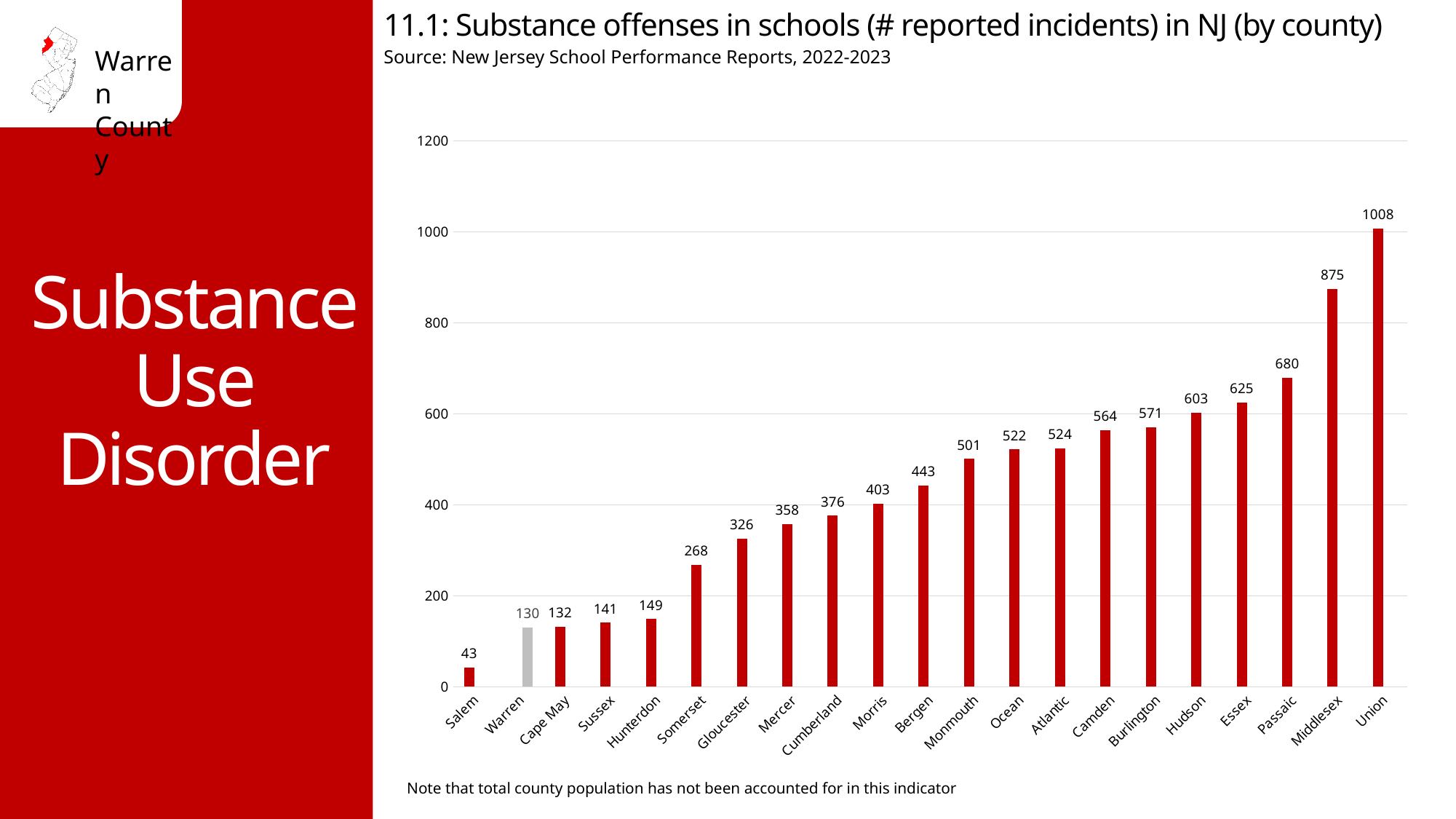
What is the value shown for Union county? 1008 Which county's bar is coloured grey instead of red? Warren Which county has the lowest number of reported incidents? Salem How many counties are shown on the x axis? 21 Which county has the highest number of reported incidents? Union What is the difference between the values for Middlesex and Passaic? 195 Is the value for Somerset greater or less than 200? greater What is the difference between the values for Warren and Salem? 87 What kind of chart is shown on the slide? Bar chart What is the value shown for Monmouth county? 501 Which has a larger value, Hudson or Bergen? Hudson What is the number of reported substance offense incidents in schools for Warren county? 130